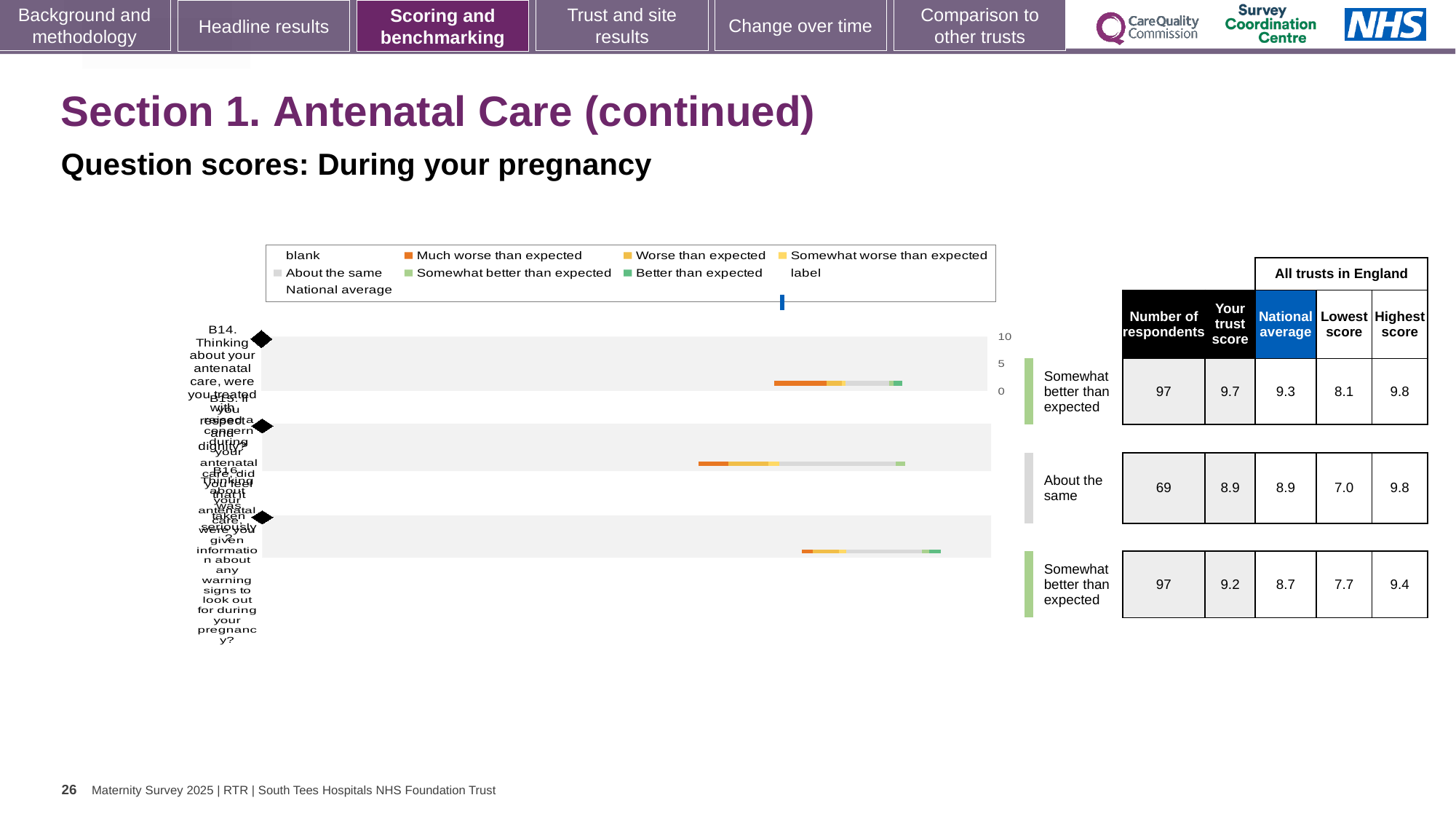
In the table beside the chart, what is the 'Your trust score' for the top row? 9.7 Which row has the lowest 'Lowest score' value? the middle row (7.0) In the table beside the chart, what is the national average for the bottom row? 8.7 For the bottom row, what is the difference between the highest score and the lowest score? 1.7 Which row has the highest 'Your trust score'? the top row (9.7) How many question rows are plotted in the chart? 3 What kind of chart is shown on the slide? bar chart In the table beside the chart, what is the highest score for the bottom row? 9.4 For the middle row, is the trust score larger than the national average, or are they equal? they are equal (8.9) What rating label is given to the middle row? About the same For the top row, how much higher is the trust score than the national average? 0.4 In the table beside the chart, what is the number of respondents for the middle row? 69